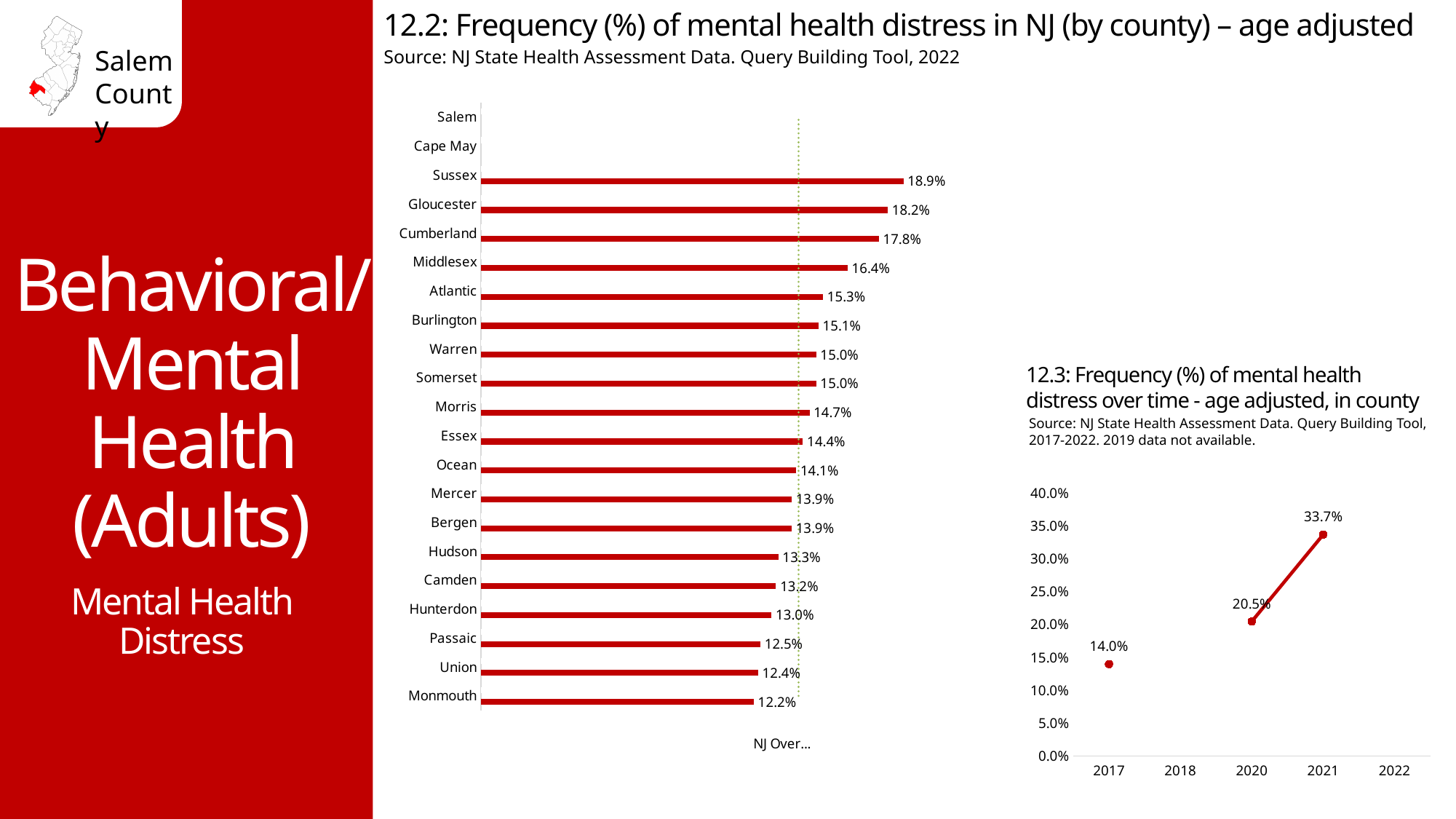
In chart 12.3, do the values rise or fall from 2017 to 2021? Rise In chart 12.2, which county has the highest frequency of mental health distress? Sussex In chart 12.2, which has a higher value, Atlantic or Burlington? Atlantic In chart 12.2, what is the value for Morris? 14.7% In chart 12.3, what is the difference between the 2021 and 2017 values? 19.7% In chart 12.2, what is the frequency of mental health distress for Sussex? 18.9% In chart 12.3, what is the frequency of mental health distress in 2021? 33.7% In chart 12.3, how many data points are plotted? 3 In chart 12.2, which county has the lowest labeled frequency of mental health distress? Monmouth In chart 12.2, what is the difference between the values for Gloucester and Cumberland? 0.4% In chart 12.2, which two counties have no bar plotted? Salem and Cape May What kind of chart is chart 12.2? Bar chart